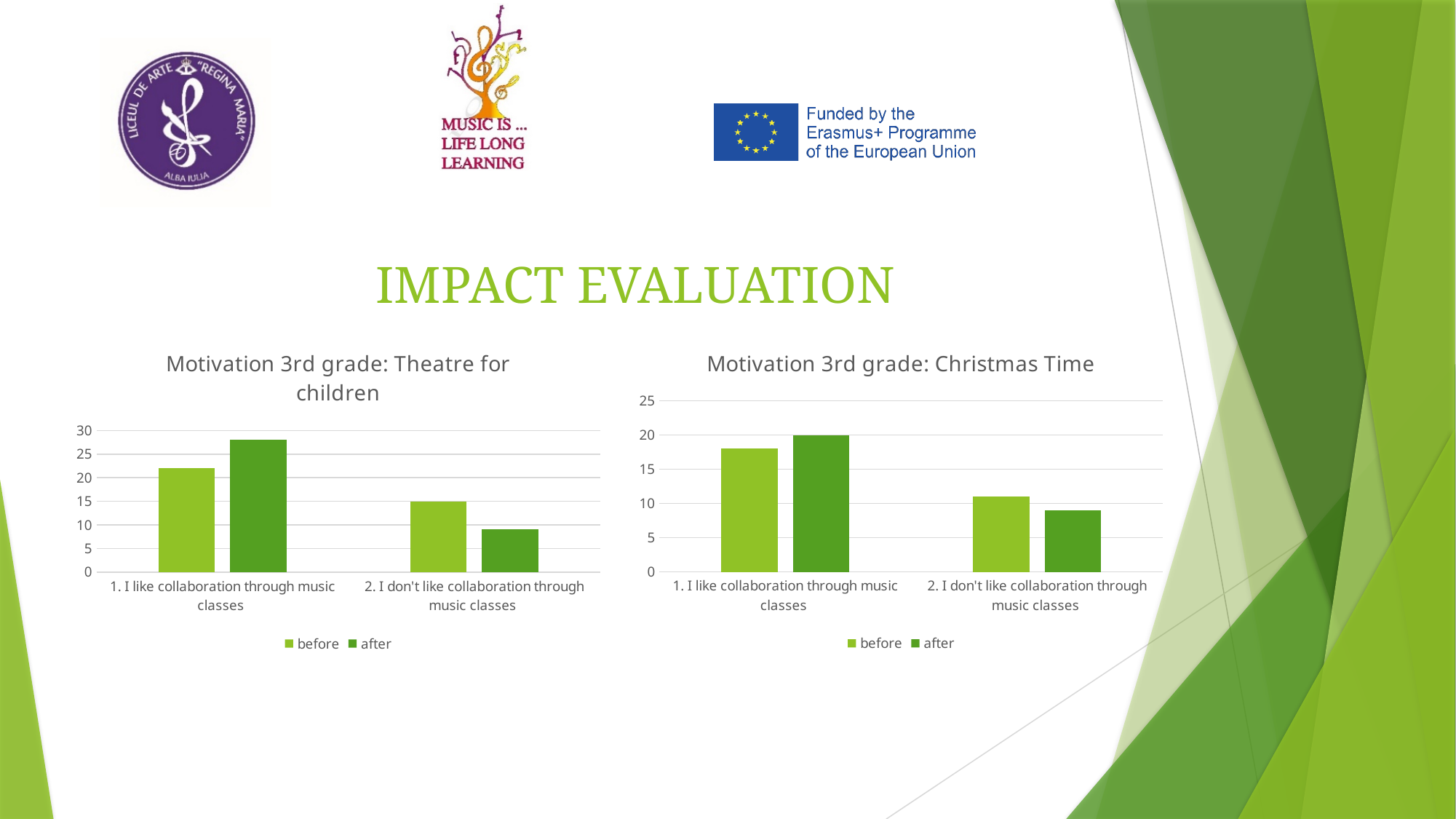
In the chart titled "Motivation 3rd grade: Christmas Time", is the value for "after" in the category "2. I don't like collaboration through music classes" greater or less than 10? less In the chart titled "Motivation 3rd grade: Christmas Time", what is the value for "after" in the category "1. I like collaboration through music classes"? 20 In the chart titled "Motivation 3rd grade: Theatre for children", which series has the higher value in the category "1. I like collaboration through music classes", before or after? after How many categories are shown on the x axis of the chart titled "Motivation 3rd grade: Christmas Time"? 2 In the chart titled "Motivation 3rd grade: Christmas Time", which series has the higher value in the category "2. I don't like collaboration through music classes", before or after? before In the chart titled "Motivation 3rd grade: Theatre for children", is the value for "after" in the category "2. I don't like collaboration through music classes" greater or less than 10? less How many series does the legend list in the chart titled "Motivation 3rd grade: Christmas Time"? 2 What kind of chart is the chart titled "Motivation 3rd grade: Theatre for children"? bar chart In the chart titled "Motivation 3rd grade: Theatre for children", which bar is the tallest? after, 1. I like collaboration through music classes In the chart titled "Motivation 3rd grade: Theatre for children", what is the value for "before" in the category "2. I don't like collaboration through music classes"? 15 In the chart titled "Motivation 3rd grade: Christmas Time", is the value for "before" in the category "1. I like collaboration through music classes" greater or less than 15? greater